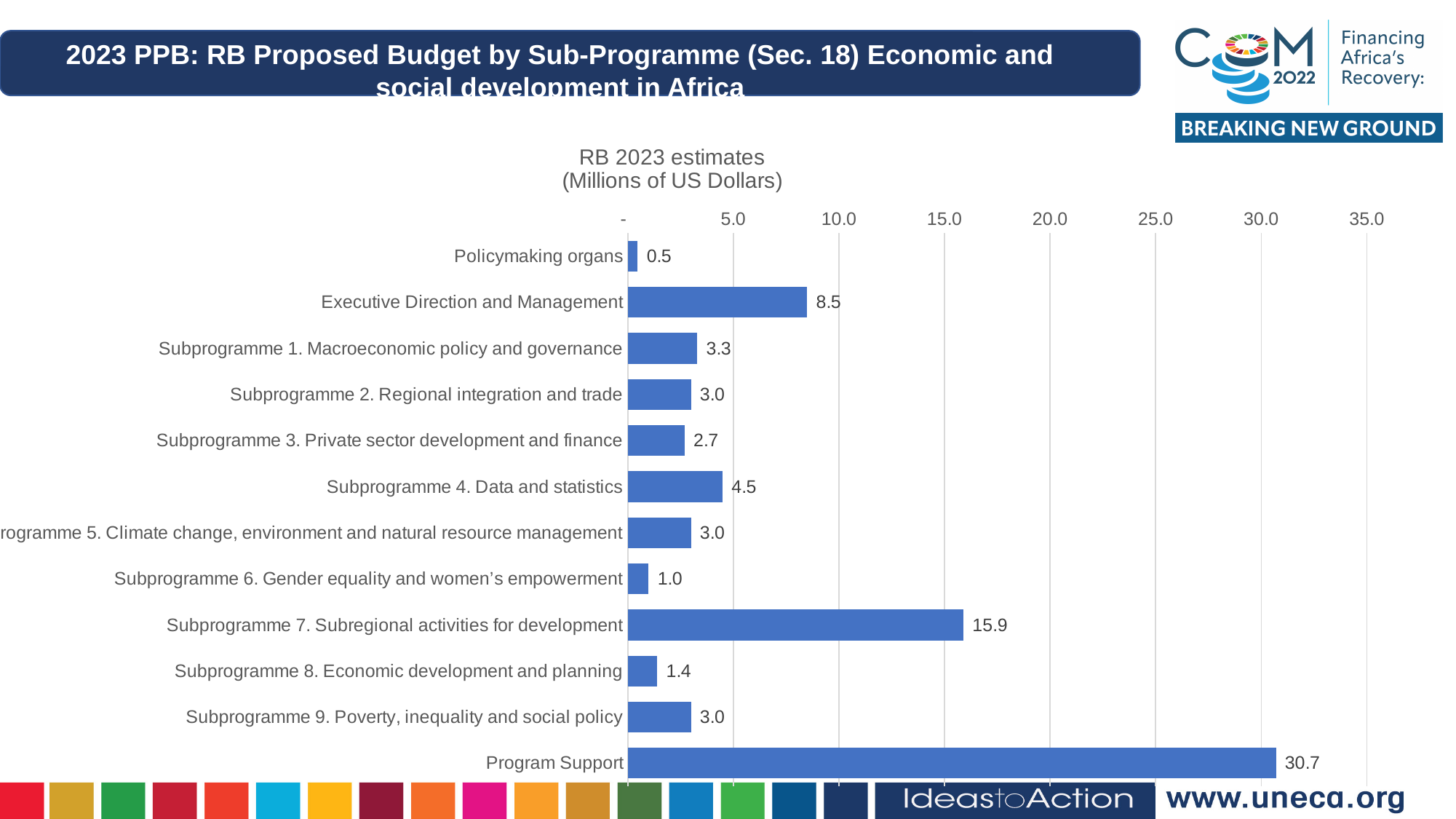
Is the value for Subprogramme 7. Subregional activities for development greater or less than 15.0? greater What kind of chart is shown on the slide? Bar chart What is the title of the chart? RB 2023 estimates (Millions of US Dollars) What is the difference between the RB 2023 estimates for Executive Direction and Management and Subprogramme 6. Gender equality and women's empowerment? 7.5 What is the RB 2023 estimate for Subprogramme 8. Economic development and planning? 1.4 What is the RB 2023 estimate for Executive Direction and Management? 8.5 Which category has the lowest RB 2023 estimate? Policymaking organs What is the RB 2023 estimate for Subprogramme 4. Data and statistics? 4.5 Which has a larger RB 2023 estimate, Subprogramme 1. Macroeconomic policy and governance or Subprogramme 3. Private sector development and finance? Subprogramme 1. Macroeconomic policy and governance How many categories are shown in the chart? 12 What is the difference between the RB 2023 estimates for Program Support and Subprogramme 7. Subregional activities for development? 14.8 Which category has the highest RB 2023 estimate? Program Support